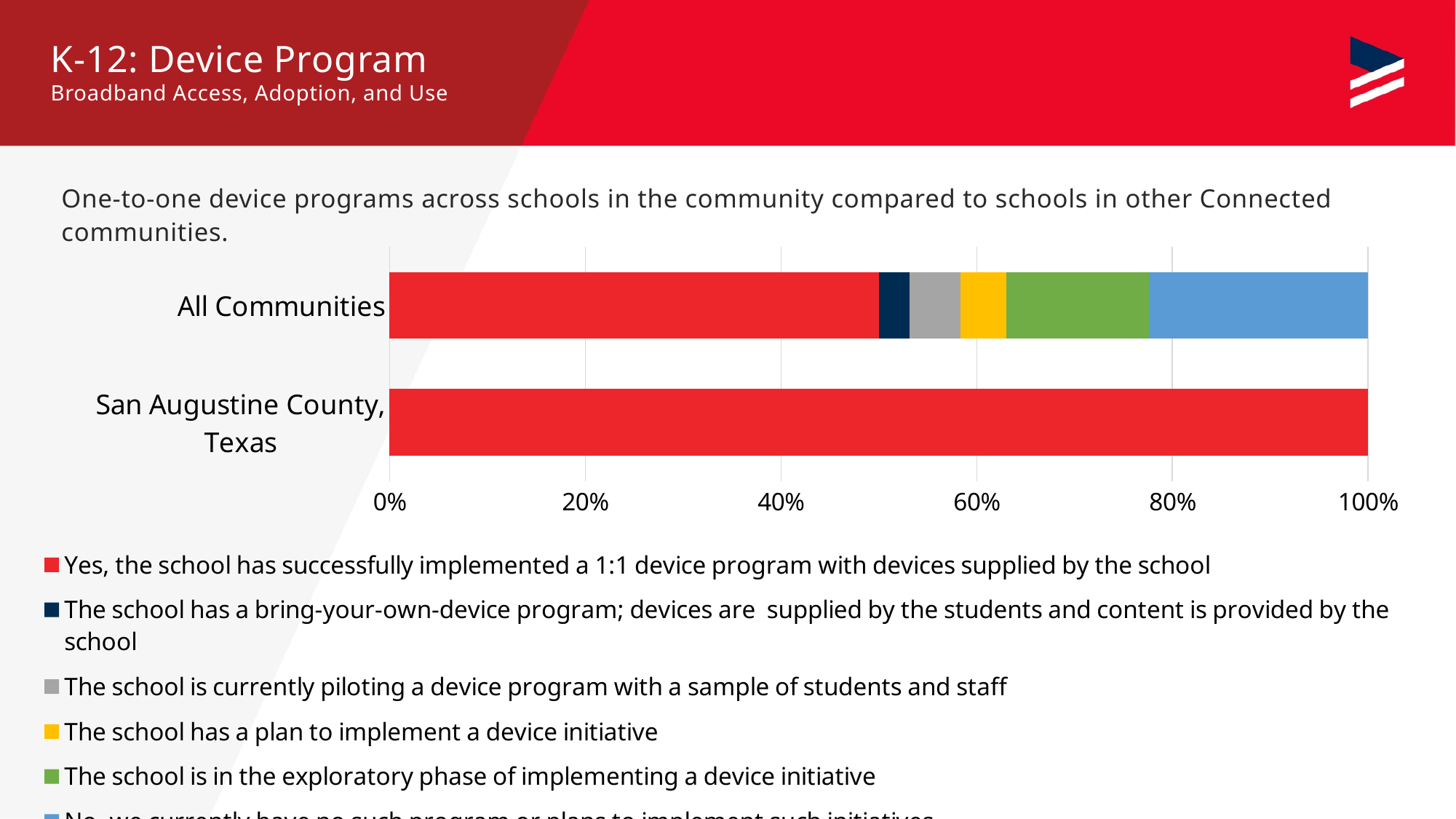
Is the share of All Communities schools that have successfully implemented a 1:1 device program greater or less than 60%? less Which category's bar is made up of the most segments? All Communities What colour represents 'Yes, the school has successfully implemented a 1:1 device program with devices supplied by the school' in the legend? Red How many categories (communities) are plotted on the chart? 2 Is the share of All Communities schools that have successfully implemented a 1:1 device program greater or less than 40%? greater What share of schools in San Augustine County, Texas have successfully implemented a 1:1 device program with devices supplied by the school? 100% Which community has the larger share of schools that have successfully implemented a 1:1 device program, All Communities or San Augustine County, Texas? San Augustine County, Texas What is the highest value shown on the horizontal axis? 100% How many series does the chart's legend list? 6 What kind of chart is shown on the slide? Bar chart Which category is listed at the top of the chart? All Communities